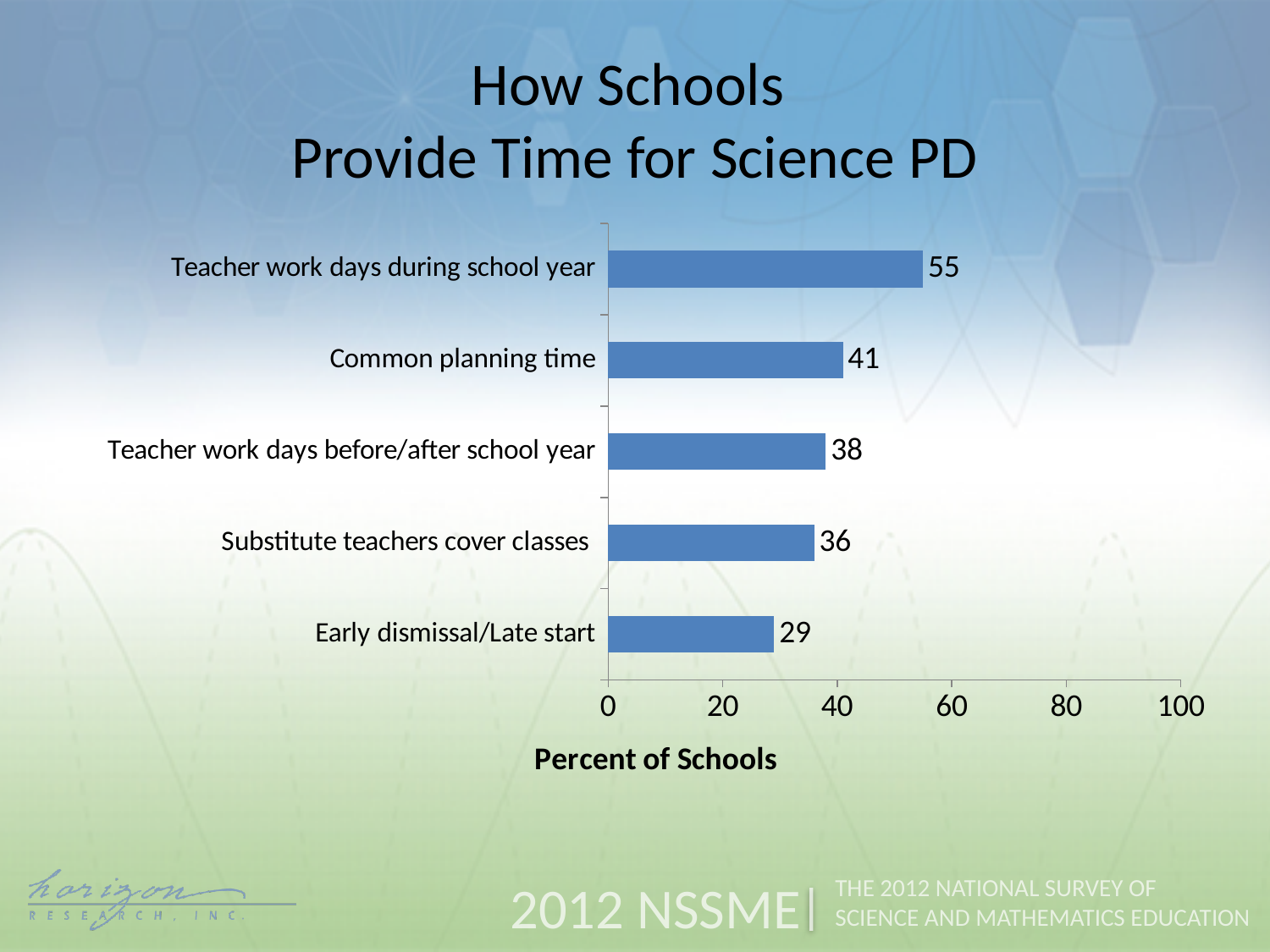
Which category has the highest percent of schools? Teacher work days during school year Which is larger: the value for Teacher work days before/after school year or the value for Substitute teachers cover classes? Teacher work days before/after school year How many categories are shown in the chart? 5 What is the value for Early dismissal/Late start? 29 What is the label of the horizontal axis? Percent of Schools What is the difference between the values for Teacher work days during school year and Early dismissal/Late start? 26 Which category has the lowest percent of schools? Early dismissal/Late start What is the value for Common planning time? 41 Is the value for Common planning time greater or less than 40? greater What percent of schools provide time for science PD through teacher work days during the school year? 55 What is the difference between the values for Common planning time and Substitute teachers cover classes? 5 What kind of chart is shown on the slide? Bar chart